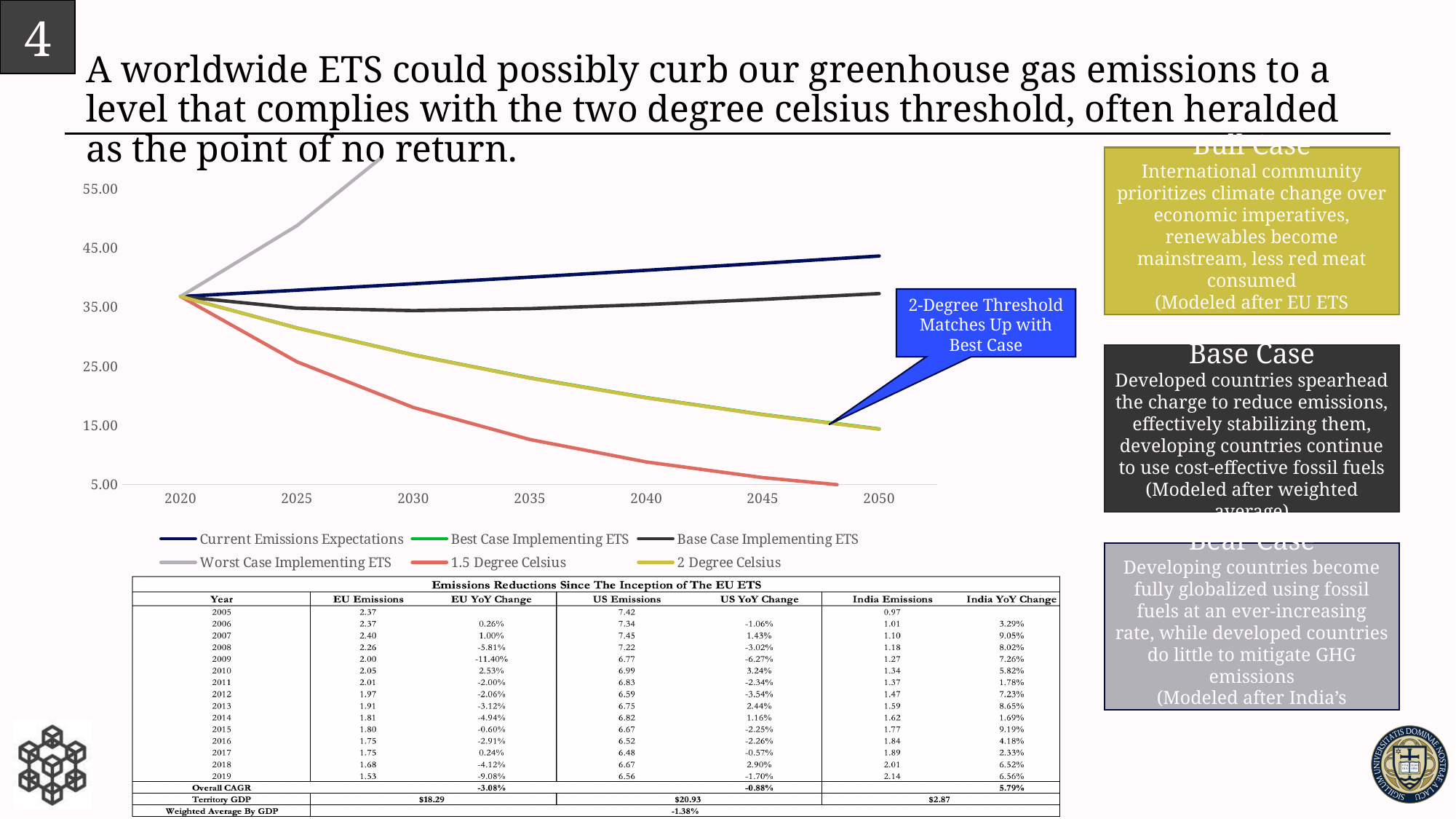
What kind of chart is shown on the slide? line chart How many series does the chart's legend list? 6 What does the blue callout on the chart say? 2-Degree Threshold Matches Up with Best Case Which series has the lowest value in 2045? 1.5 Degree Celsius In 2050, which is higher: Current Emissions Expectations or Base Case Implementing ETS? Current Emissions Expectations In 2040, which is higher: 1.5 Degree Celsius or 2 Degree Celsius? 2 Degree Celsius Is the value for 1.5 Degree Celsius in 2045 greater or less than 15.00? less Is the value for Worst Case Implementing ETS in 2025 greater or less than 45.00? greater Does the 1.5 Degree Celsius line rise or fall from 2020 to 2045? fall Is the value for 2 Degree Celsius in 2050 greater or less than 25.00? less Does the Current Emissions Expectations line rise or fall from 2020 to 2050? rise